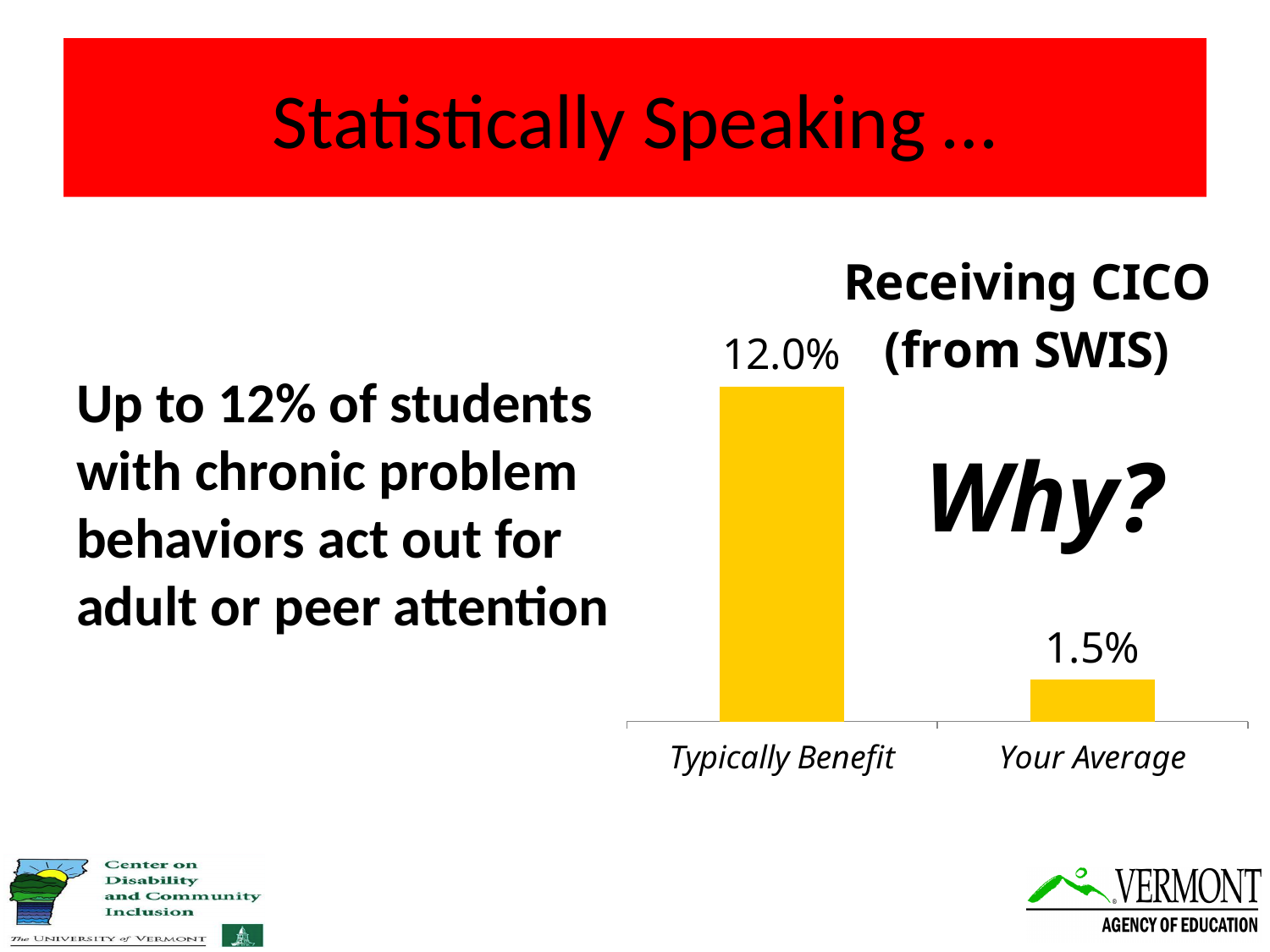
What colour are the bars in the chart? Yellow Which category has the lowest value? Your Average What is the value for Typically Benefit? 12.0% What is the value for Your Average? 1.5% What is the difference between the Typically Benefit and Your Average values? 10.5% Which category has the highest value? Typically Benefit Do the values rise or fall from Typically Benefit to Your Average? Fall What kind of chart is shown on the slide? Bar chart How many categories are shown on the chart? 2 What is the title of the chart? Receiving CICO (from SWIS) Which is larger, Typically Benefit or Your Average? Typically Benefit